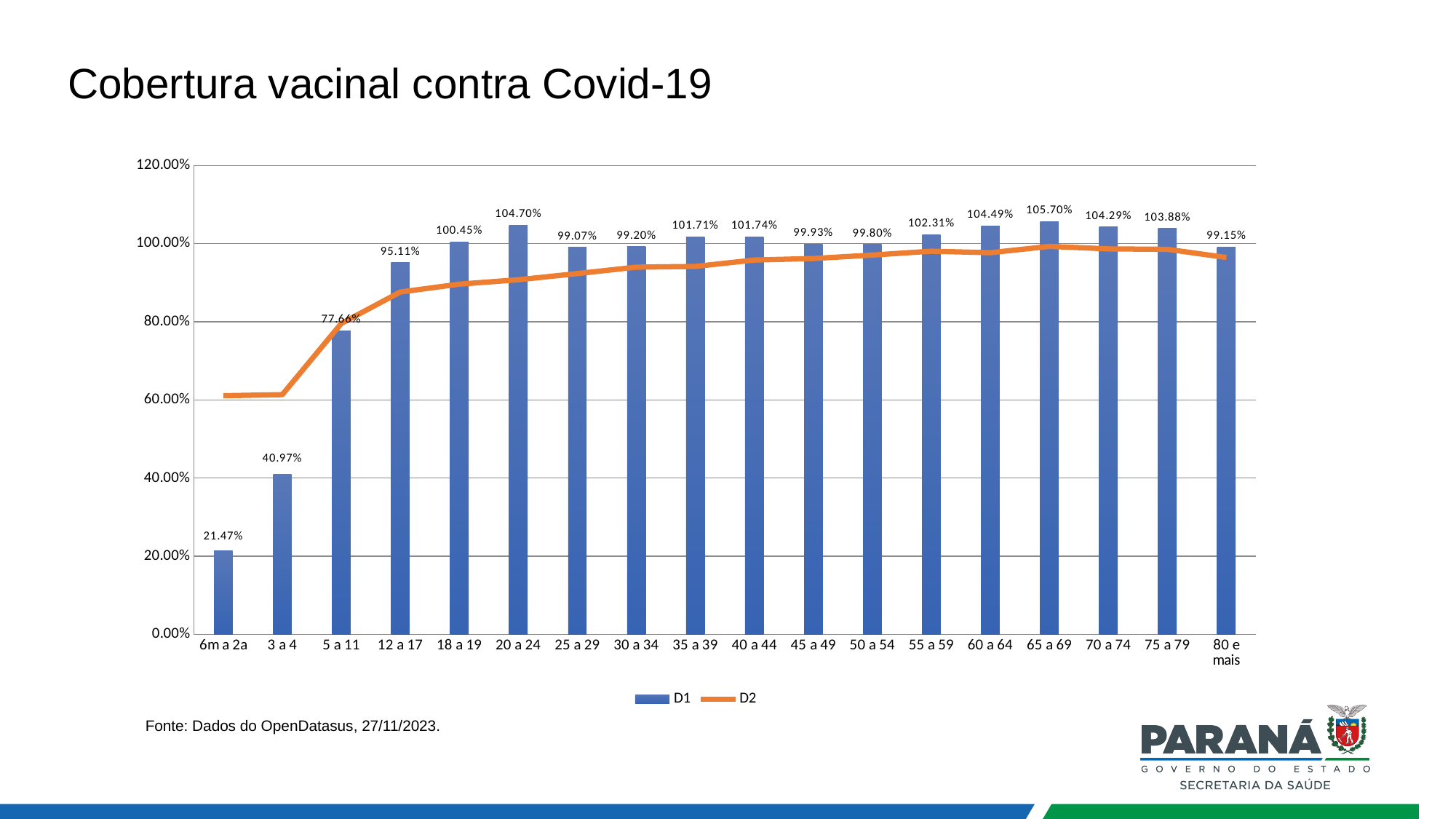
How many age groups are shown on the x axis? 18 Does the D2 line rise or fall from 6m a 2a to 12 a 17? rise Is the D2 value for 12 a 17 greater or less than 80.00%? greater Which age group has the highest D1 value? 65 a 69 How many series does the legend list? 2 Is the D2 value for 80 e mais greater or less than 100.00%? less What is the difference between the D1 values for 12 a 17 and 5 a 11? 17.45 percentage points What is the D1 value for the 20 a 24 age group? 104.70% What is the D1 value for the 80 e mais age group? 99.15% What is the D1 value for the 6m a 2a age group? 21.47% Which age group has the lowest D1 value? 6m a 2a Which has a larger D1 value, 65 a 69 or 20 a 24? 65 a 69